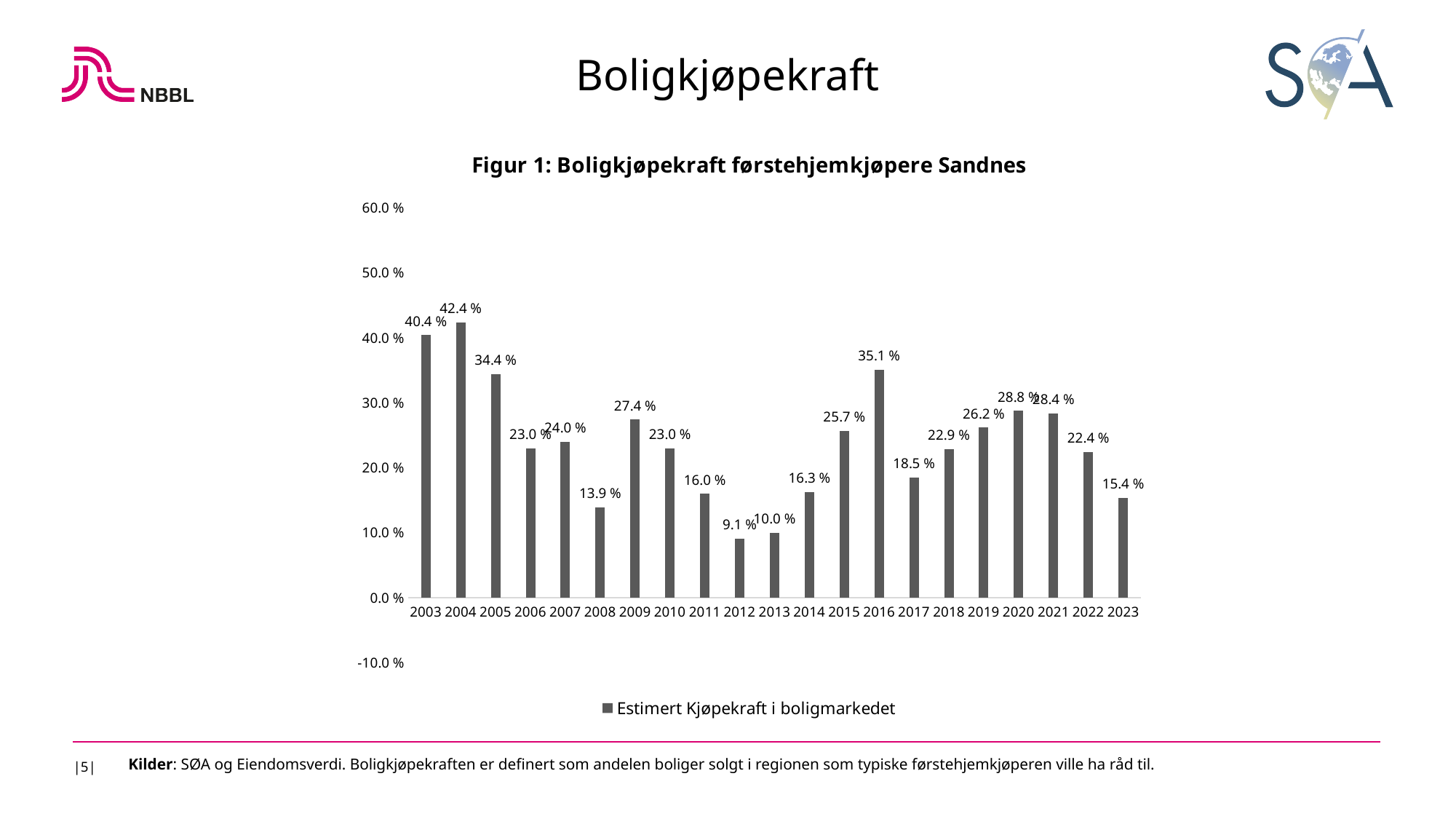
How many series does the legend list? 1 Is the value for 2005 greater or less than 30.0 %? greater Which year has the lowest value? 2012 Which is larger, the value for 2009 or the value for 2015? 2009 What is the difference between the values for 2016 and 2017? 16.6 % What is the title of the chart? Figur 1: Boligkjøpekraft førstehjemkjøpere Sandnes How many years are shown on the x axis? 21 Which year has the highest value? 2004 What is the value for 2004? 42.4 % What kind of chart is this? bar chart What is the value for 2012? 9.1 % What is the value for 2023? 15.4 %